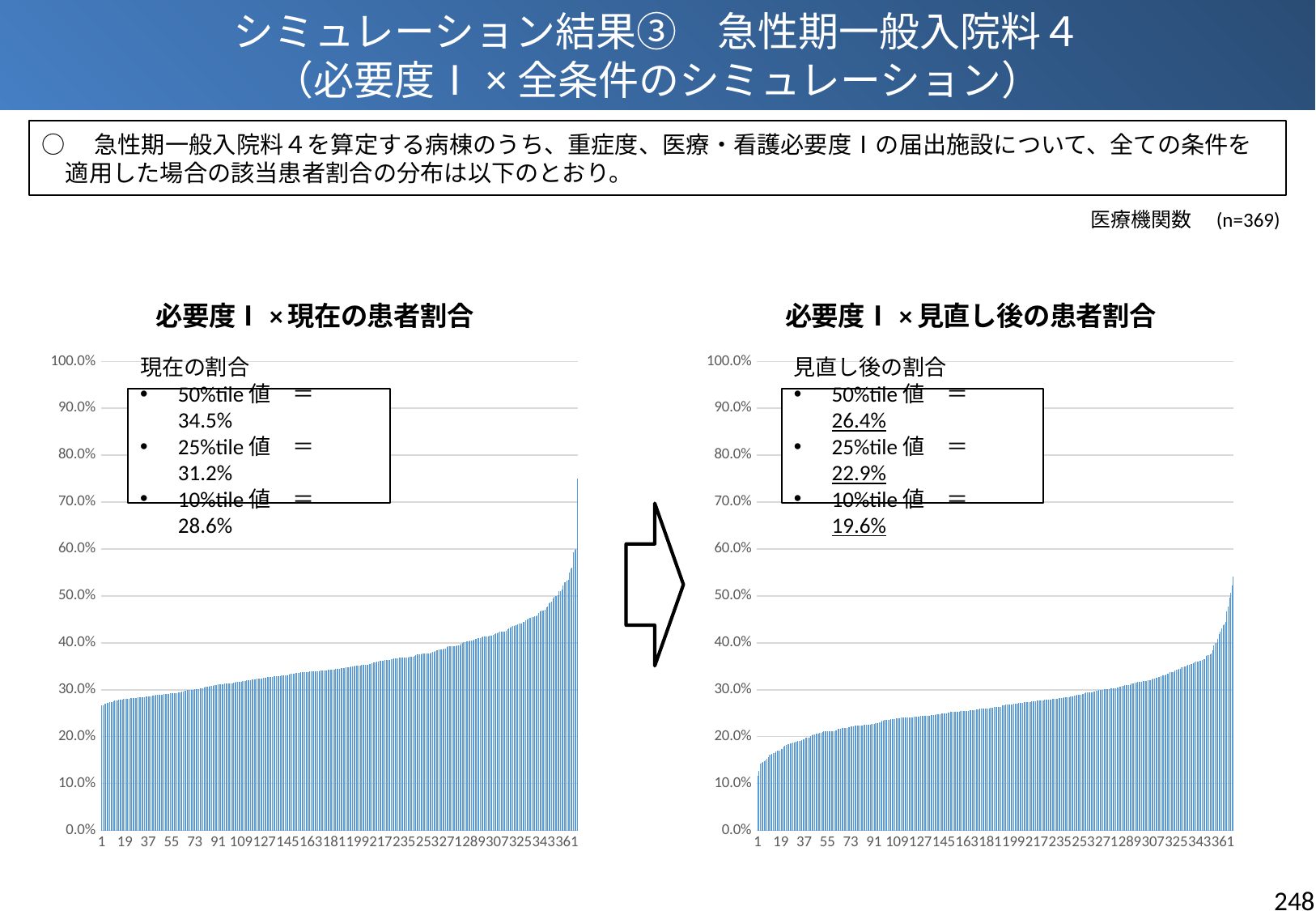
What is the difference between the 50%tile value on the left chart (34.5%) and the 50%tile value on the right chart (26.4%)? 8.1 percentage points According to the annotation on the left chart (必要度Ⅰ×現在の患者割合), what is the 50%tile value? 34.5% How many medical institutions (医療機関数) are included in the data shown on the slide? 369 According to the annotation on the left chart (必要度Ⅰ×現在の患者割合), what is the 10%tile value? 28.6% In the right chart (必要度Ⅰ×見直し後の患者割合), is the value of the first (leftmost) bar greater or less than 20.0%? less In the left chart (必要度Ⅰ×現在の患者割合), do the bar values rise or fall from left to right along the x axis? rise According to the annotation on the right chart (必要度Ⅰ×見直し後の患者割合), what is the 25%tile value? 22.9% Which chart has the larger 10%tile value, the left chart (必要度Ⅰ×現在の患者割合) or the right chart (必要度Ⅰ×見直し後の患者割合)? the left chart (必要度Ⅰ×現在の患者割合) In the right chart (必要度Ⅰ×見直し後の患者割合), do the bar values rise or fall from left to right along the x axis? rise What kind of chart is the left chart titled 必要度Ⅰ×現在の患者割合? bar chart According to the annotation on the right chart (必要度Ⅰ×見直し後の患者割合), what is the 50%tile value? 26.4% In the left chart (必要度Ⅰ×現在の患者割合), is the value of the first (leftmost) bar greater or less than 20.0%? greater